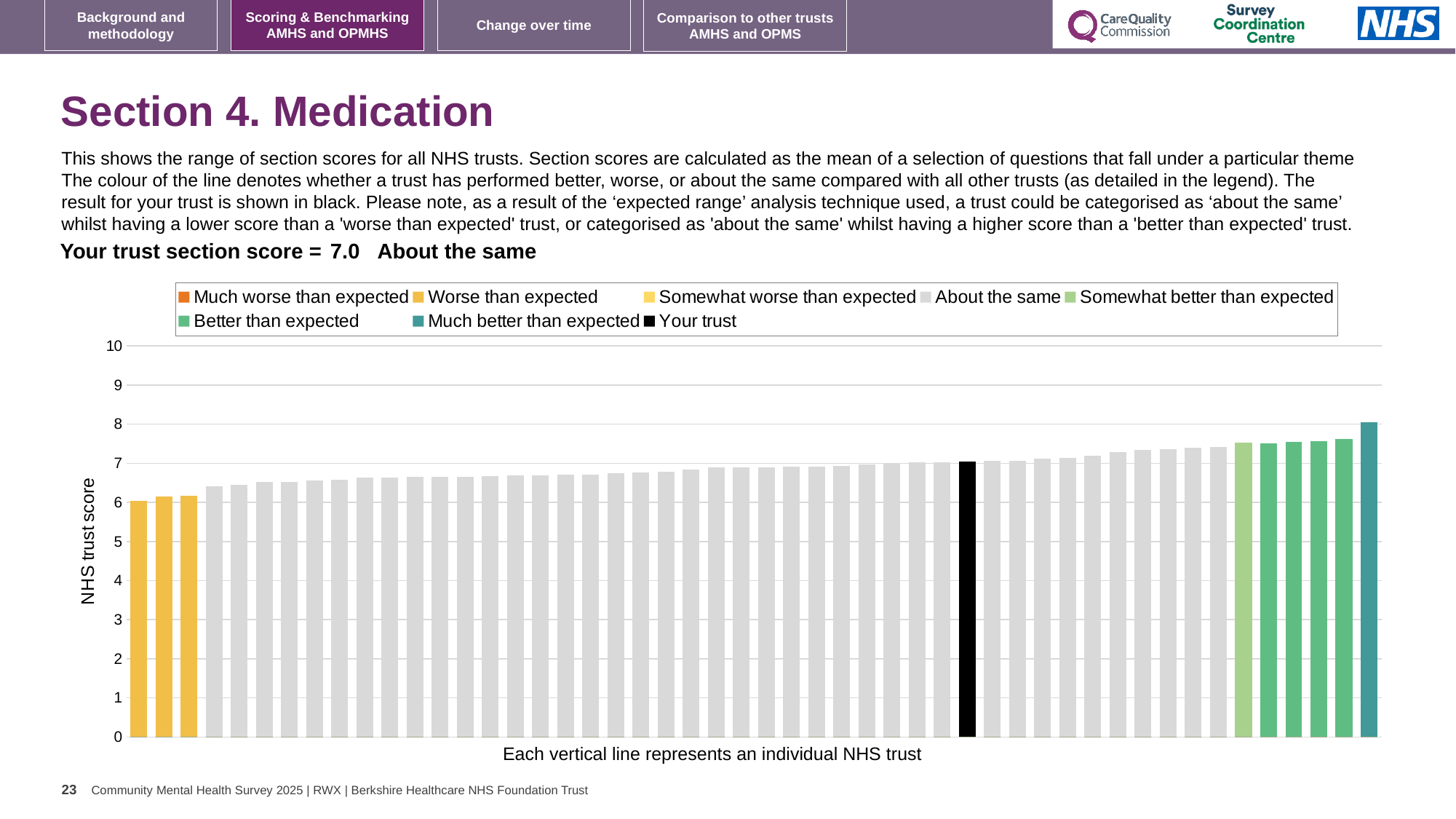
Is the value of the tallest bar (Much better than expected) greater or less than 7? greater How many bars are coloured as 'Better than expected'? 4 How many bars are coloured as 'Worse than expected'? 3 How many bars are coloured as 'Much better than expected'? 1 What is the label on the vertical axis of the chart? NHS trust score Is the value of the leftmost bar greater or less than 7? less How many entries does the chart legend list? 8 Do the bar values rise or fall from left to right along the x axis? rise What kind of chart is shown on the slide? bar chart Which performance category is your trust placed in for this section? About the same Is the value of the black 'Your trust' bar greater or less than 6? greater What is the section score for your trust? 7.0